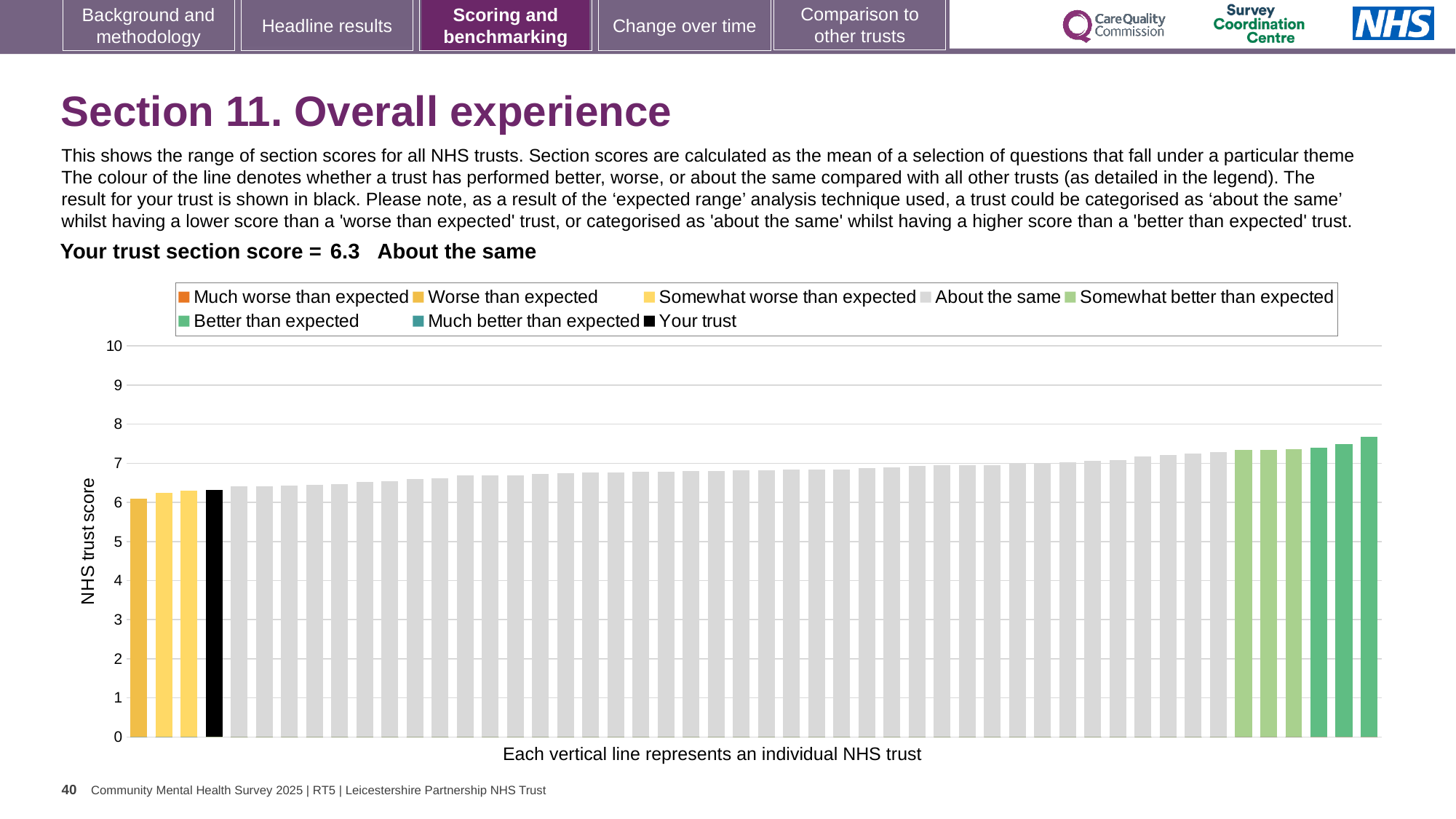
Is the value of the tallest bar (rightmost) greater or less than 7? greater Which legend category does the tallest bar on the chart belong to? Better than expected Is the value of the shortest bar (leftmost) greater or less than 5? greater How many entries does the chart legend list? 8 What colour is used for the 'Your trust' bar in the chart? black What is the section score for your trust shown on the slide? 6.3 Is the value of the black 'Your trust' bar greater or less than 5? greater What is the label on the vertical axis of the chart? NHS trust score Do the bar values rise or fall from left to right along the x axis? rise Which category is your trust placed in for this section? About the same What kind of chart is shown on the slide? bar chart